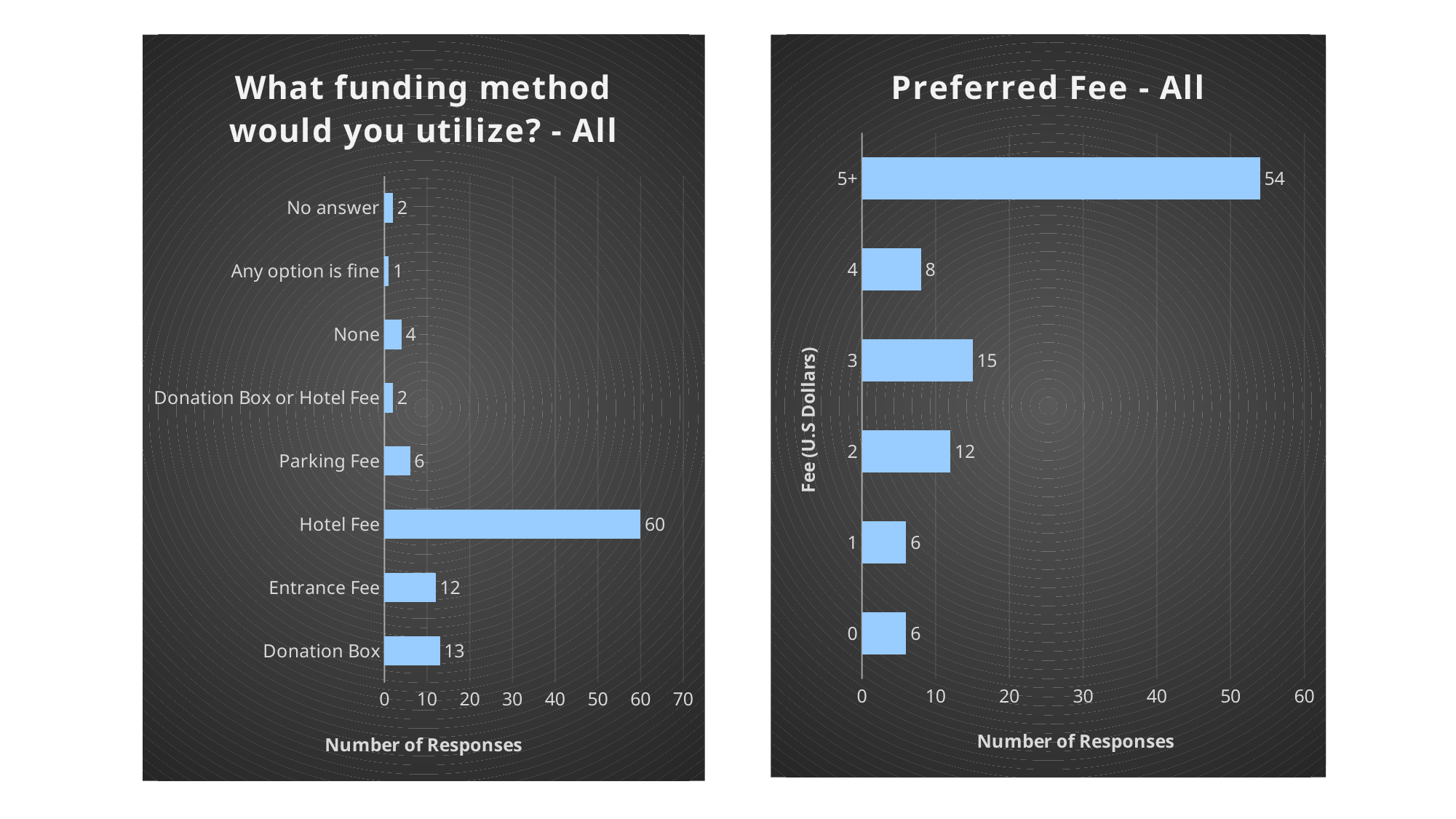
What is the y-axis label of the 'Preferred Fee - All' chart? Fee (U.S Dollars) In the 'What funding method would you utilize? - All' chart, what is the difference in responses between Donation Box and Entrance Fee? 1 What type of chart is 'Preferred Fee - All'? Bar chart In the 'Preferred Fee - All' chart, which fee level received the most responses? 5+ In the 'What funding method would you utilize? - All' chart, which funding method received the most responses? Hotel Fee In the 'Preferred Fee - All' chart, how many responses did the 5+ fee receive? 54 In the 'What funding method would you utilize? - All' chart, how many responses did Hotel Fee receive? 60 In the 'Preferred Fee - All' chart, how many responses did the $3 fee receive? 15 In the 'Preferred Fee - All' chart, what is the difference in responses between the 5+ fee and the $4 fee? 46 In the 'What funding method would you utilize? - All' chart, which category received the fewest responses? Any option is fine In the 'What funding method would you utilize? - All' chart, which received more responses, Parking Fee or None? Parking Fee In the 'What funding method would you utilize? - All' chart, how many categories are shown? 8